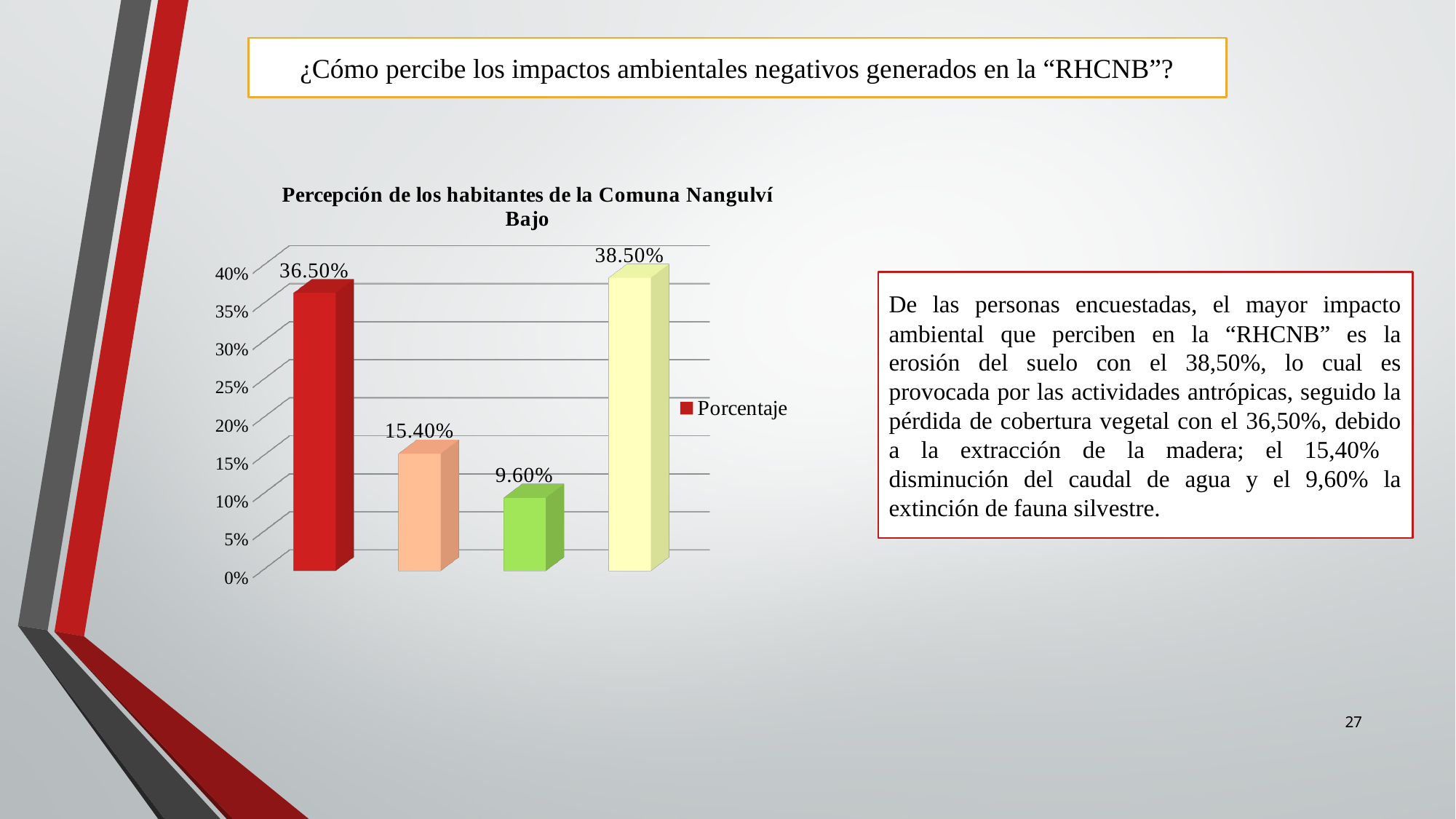
What is the difference between the value of the fourth (yellow) bar and the first (red) bar? 2.00% How many bars are plotted in the chart? 4 What is the highest value shown in the chart? 38.50% What is the name of the series shown in the chart legend? Porcentaje What value is labelled on the second (peach) bar of the chart? 15.40% What value is labelled on the first (red) bar of the chart? 36.50% How many series does the chart legend list? 1 What value is labelled on the third (green) bar of the chart? 9.60% What is the lowest value shown in the chart? 9.60% What value is labelled on the fourth (yellow) bar of the chart? 38.50% What is the title of the chart? Percepción de los habitantes de la Comuna Nangulví Bajo What kind of chart is shown on the slide? bar chart